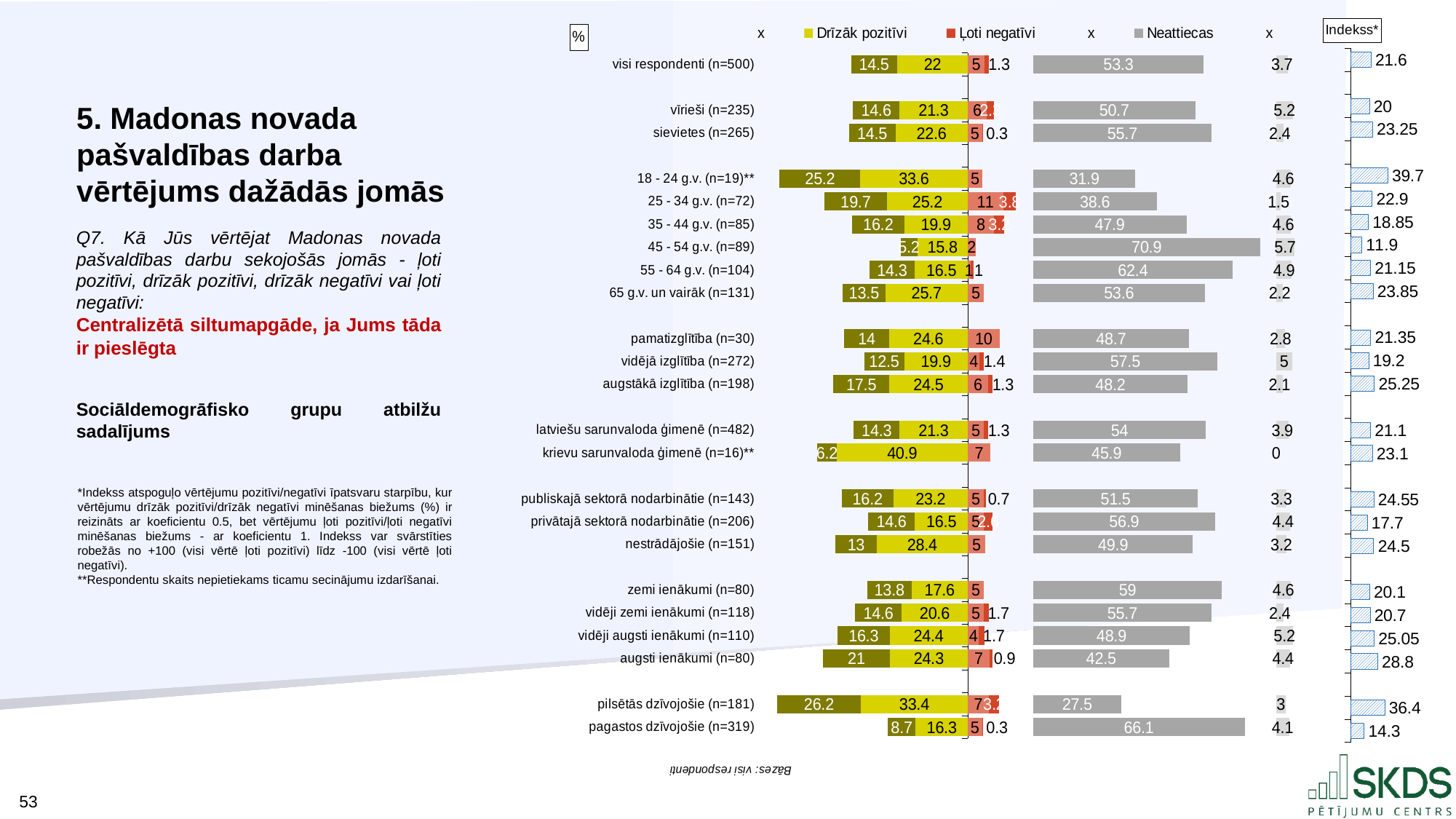
What is the difference between the Neattiecas values for sievietes (n=265) and vīrieši (n=235)? 5 Which group has the lowest Neattiecas value? pilsētās dzīvojošie (n=181) What is the Drīzāk pozitīvi value for pagastos dzīvojošie (n=319)? 16.3 Which group has the highest Indekss value? 18 - 24 g.v. (n=19)** What is the difference between the Indekss values for pilsētās dzīvojošie (n=181) and pagastos dzīvojošie (n=319)? 22.1 Which has the larger Drīzāk pozitīvi value: pilsētās dzīvojošie (n=181) or pagastos dzīvojošie (n=319)? pilsētās dzīvojošie (n=181) What kind of chart is shown on the slide? bar chart What is the Neattiecas value for visi respondenti (n=500)? 53.3 Which group has the lowest Indekss value? 45 - 54 g.v. (n=89) What is the Indekss value for 18 - 24 g.v. (n=19)**? 39.7 Which group has the highest Neattiecas value? 45 - 54 g.v. (n=89)